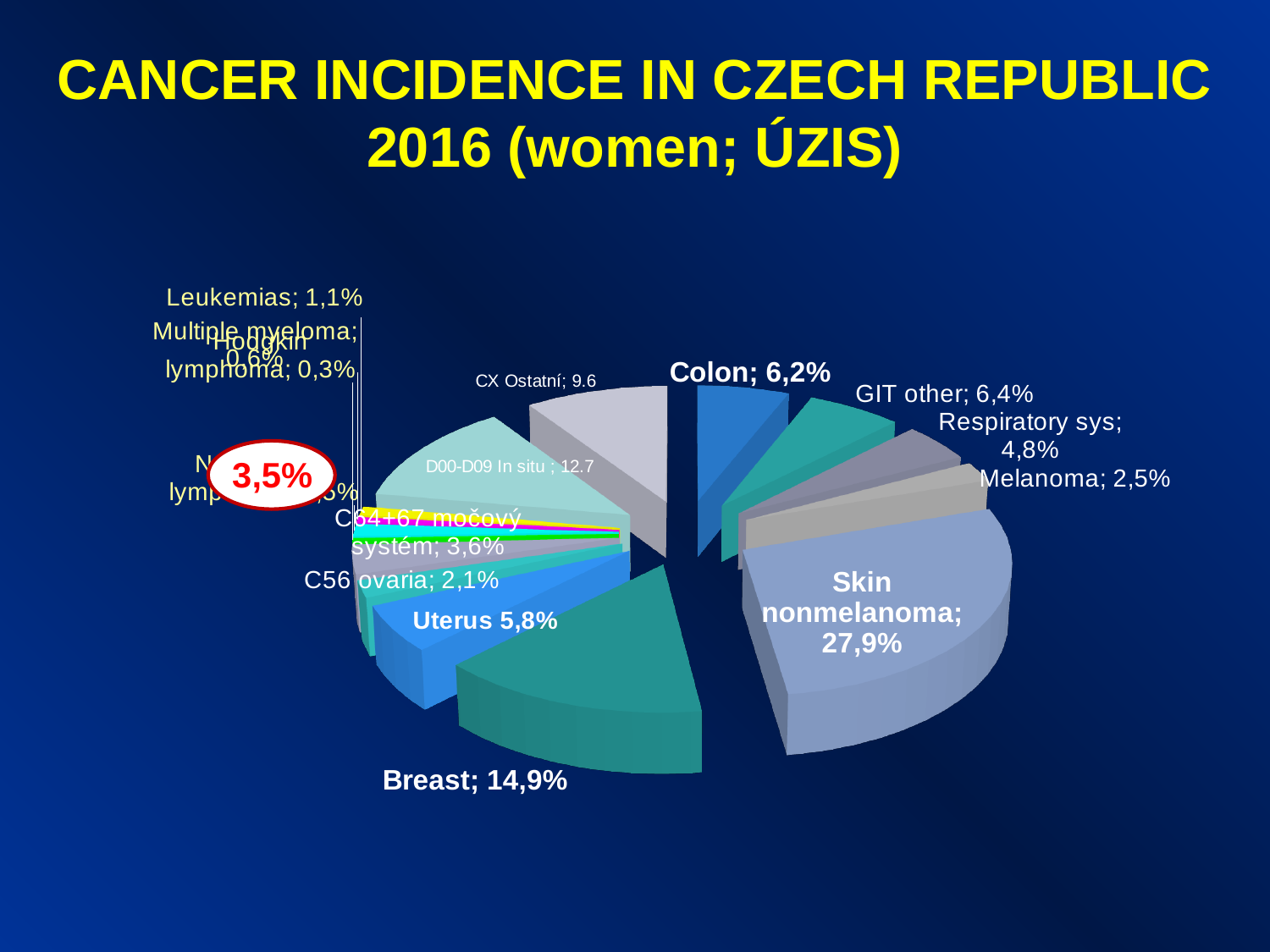
What is the value shown for Melanoma? 2,5% What is the value shown for Colon? 6,2% What is the value shown for Respiratory sys? 4,8% What share of cancer incidence is attributed to Skin nonmelanoma? 27,9% What is the value shown for Breast? 14,9% What is the value shown for Uterus? 5,8% Which is larger, the value for Colon or the value for GIT other? GIT other What is the title of the chart on the slide? CANCER INCIDENCE IN CZECH REPUBLIC 2016 (women; ÚZIS) What is the value shown for GIT other? 6,4% What kind of chart is shown on the slide? pie chart Which category has the largest slice of the pie? Skin nonmelanoma What is the value shown for Leukemias? 1,1%